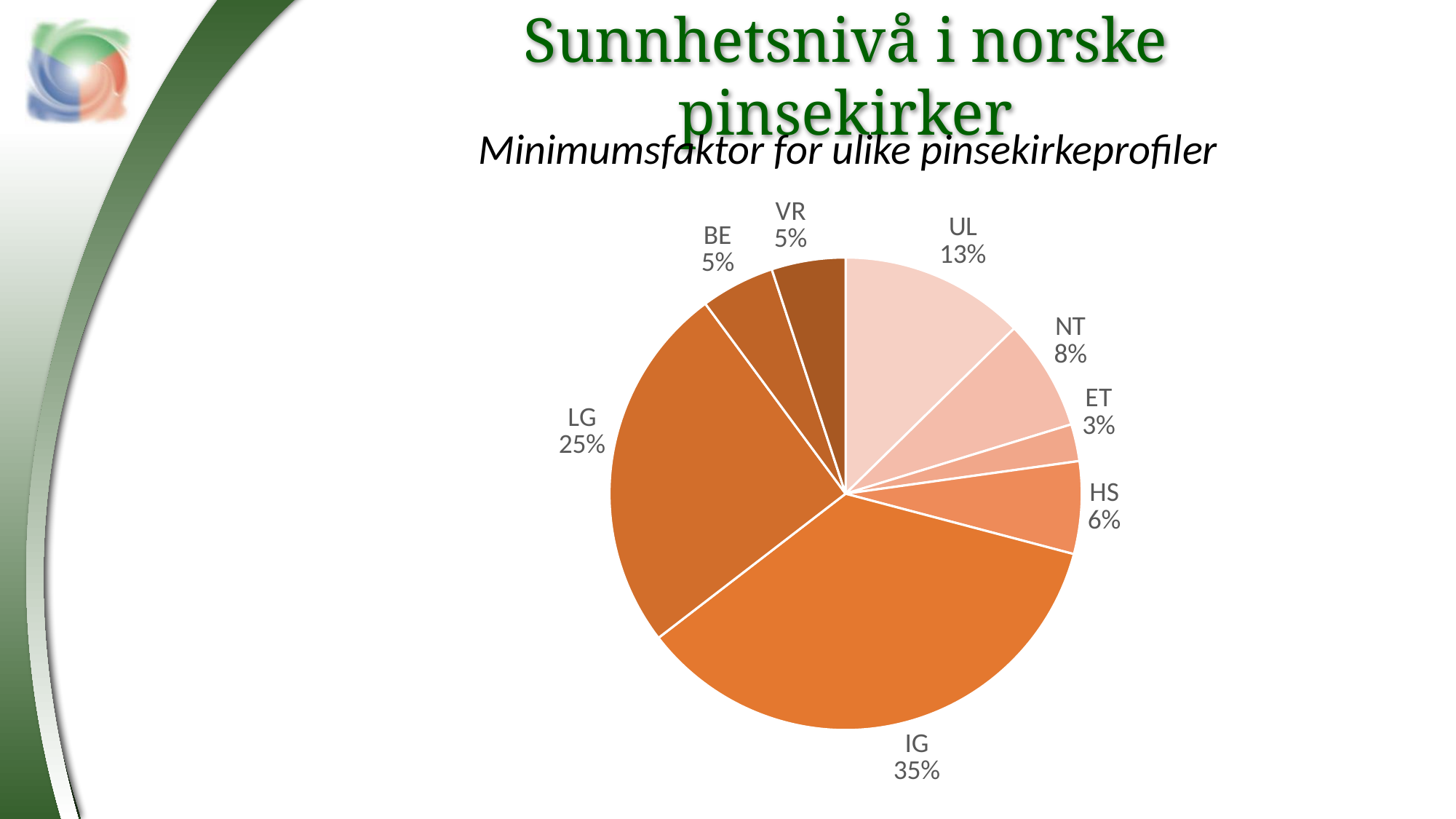
What is the title of the chart? Minimumsfaktor for ulike pinsekirkeprofiler What share of the pie does NT have? 8% What is the difference in percentage points between IG and LG? 10 What share of the pie does IG have? 35% Which is larger, the share for UL or the share for NT? UL What is the combined share of HS and ET? 9% Which category has the largest slice of the pie? IG What kind of chart is shown on the slide? Pie chart Which category has the smallest slice of the pie? ET What share of the pie does UL have? 13% How many slices does the pie chart have? 8 What share of the pie does LG have? 25%